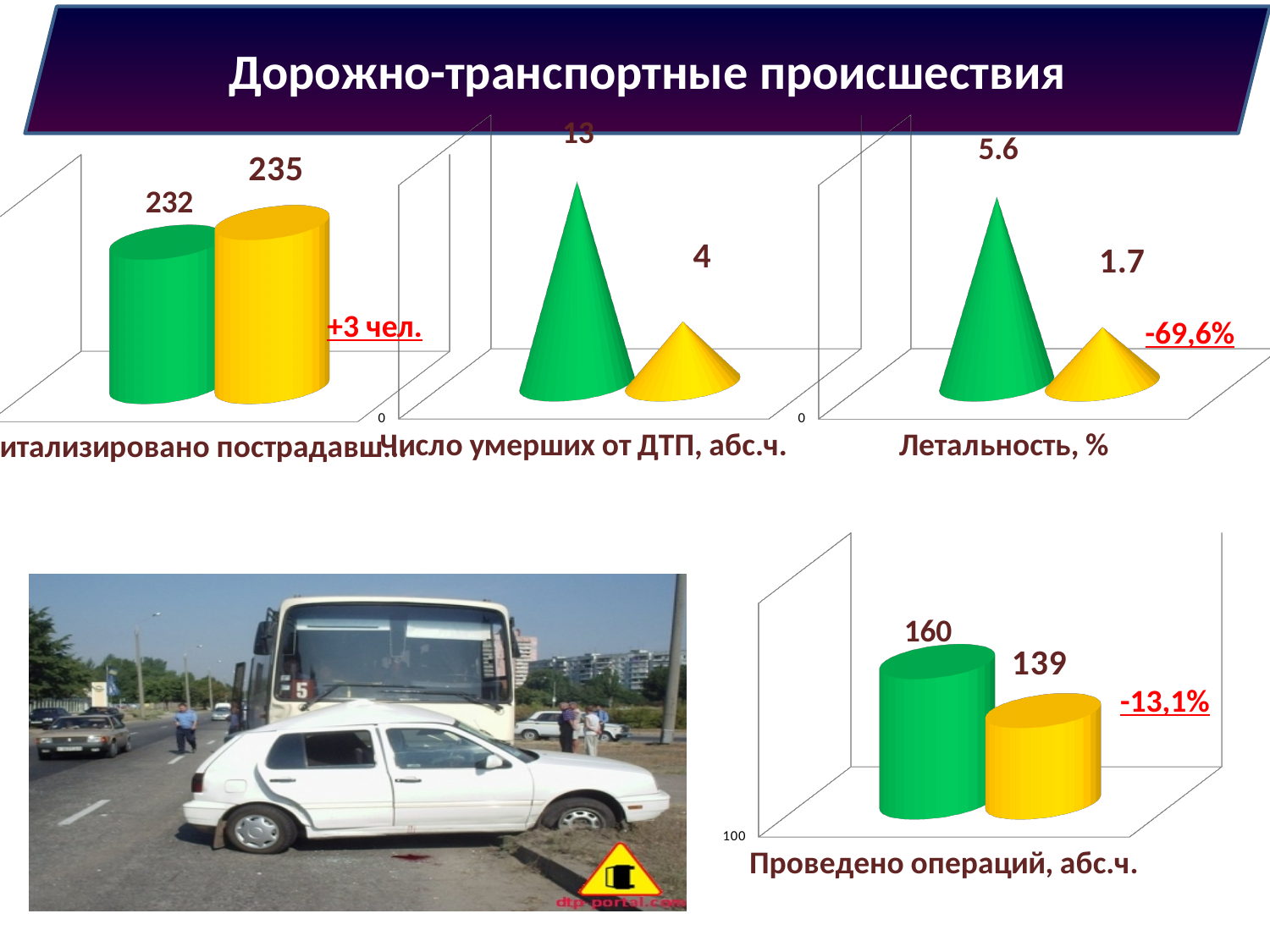
In the chart titled "Проведено операций, абс.ч.", what is the difference between the green bar and the yellow bar? 21 In the top-left chart, what is the value of the yellow bar? 235 In the chart titled "Летальность, %", what is the value of the green cone? 5.6 In the chart titled "Летальность, %", what percentage change is annotated in red? -69,6% In the chart titled "Проведено операций, абс.ч.", what is the value of the yellow bar? 139 In the top-left chart, which bar is larger, the green one or the yellow one? yellow How many data points are plotted in the chart titled "Летальность, %"? 2 In the chart titled "Число умерших от ДТП, абс.ч.", what is the value of the green cone? 13 In the chart titled "Проведено операций, абс.ч.", what percentage change is annotated in red? -13,1% In the chart titled "Летальность, %", what is the value of the yellow cone? 1.7 In the chart titled "Число умерших от ДТП, абс.ч.", what is the value of the yellow cone? 4 In the chart titled "Число умерших от ДТП, абс.ч.", what is the difference between the green and yellow values? 9